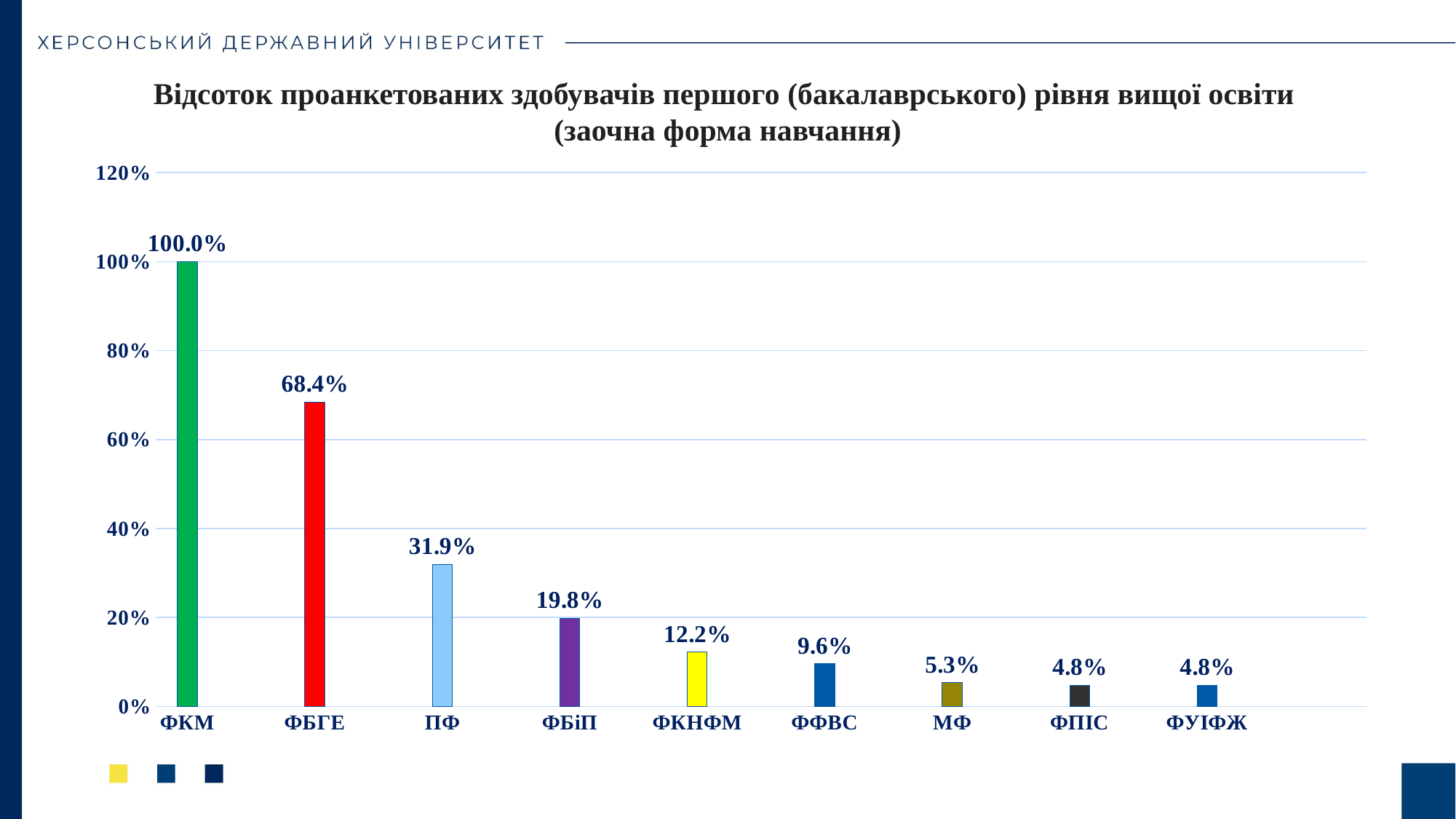
How many categories are shown on the x axis? 9 What is the value for ФФВС? 9.6% What is the value for ФКМ? 100.0% What is the difference between the values for ФБГЕ and ПФ? 36.5% What kind of chart is shown on the slide? bar chart Which category has the highest value? ФКМ Do the values rise or fall from left to right along the x axis? fall What is the value for ПФ? 31.9% What is the difference between the values for ФБіП and ФКНФМ? 7.6% Which is larger, the value for ФБіП or the value for ФФВС? ФБіП Is the value for ФБГЕ greater or less than 60%? greater What is the value for МФ? 5.3%